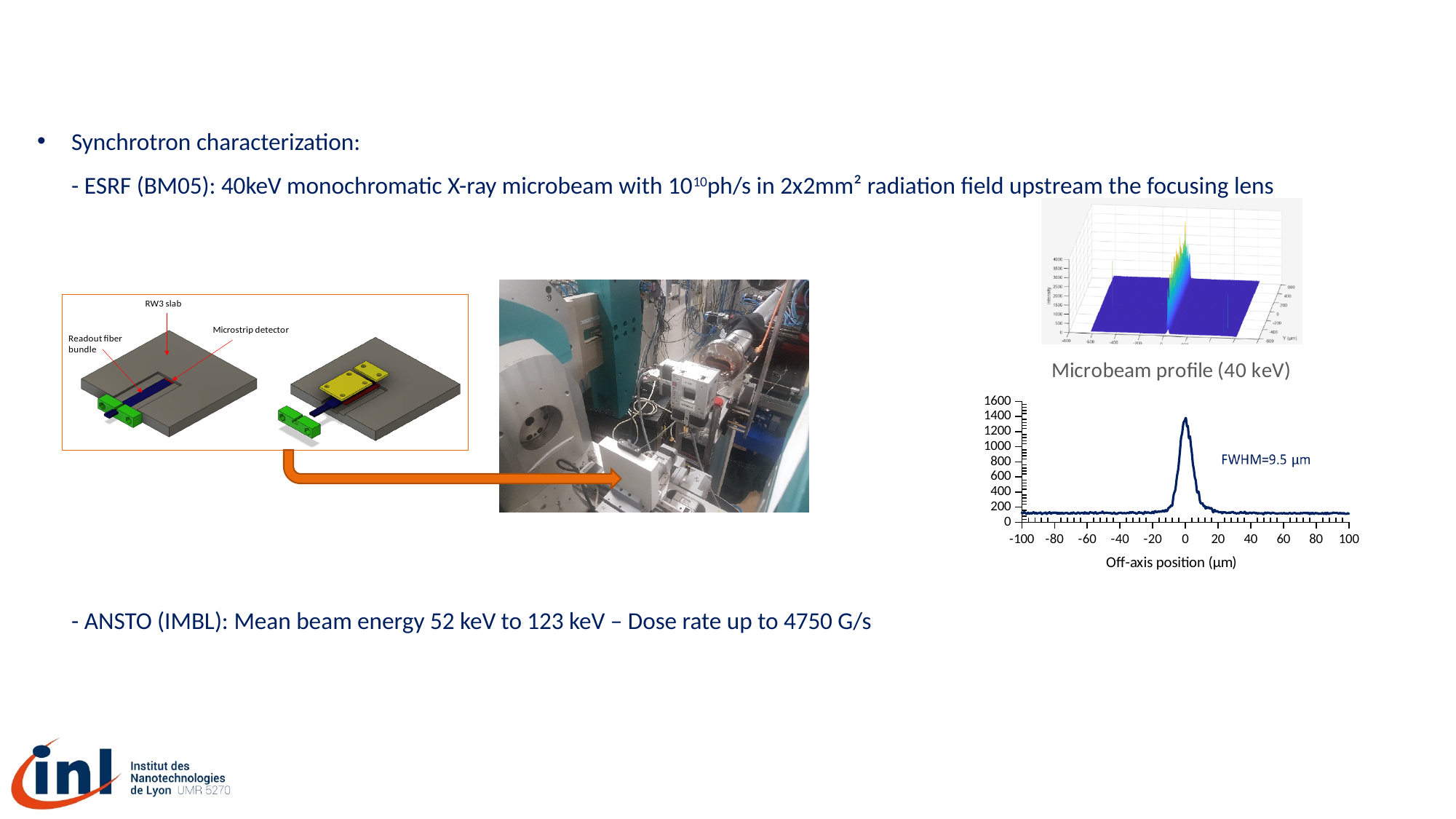
In the line chart below 'Microbeam profile (40 keV)', what is the label of the x axis? Off-axis position (µm) In the line chart below 'Microbeam profile (40 keV)', is the value at off-axis position -80 greater or less than 400? less In the line chart below 'Microbeam profile (40 keV)', is the peak value of the curve greater or less than 1600? less In the line chart below 'Microbeam profile (40 keV)', what FWHM value is annotated on the chart? FWHM=9.5 µm In the line chart below 'Microbeam profile (40 keV)', is the peak value of the curve greater or less than 1000? greater In the line chart below 'Microbeam profile (40 keV)', what is the highest tick value shown on the y axis? 1600 In the line chart below 'Microbeam profile (40 keV)', which is larger: the value at off-axis position 0 or the value at off-axis position 60? the value at 0 In the line chart below 'Microbeam profile (40 keV)', at which off-axis position does the curve reach its peak? 0 In the line chart below 'Microbeam profile (40 keV)', does the curve rise or fall as the off-axis position goes from 0 to 40? fall In the line chart below 'Microbeam profile (40 keV)', does the curve rise or fall as the off-axis position goes from -40 to 0? rise What kind of chart is the 'Microbeam profile (40 keV)' chart with the 'Off-axis position (µm)' axis? line chart